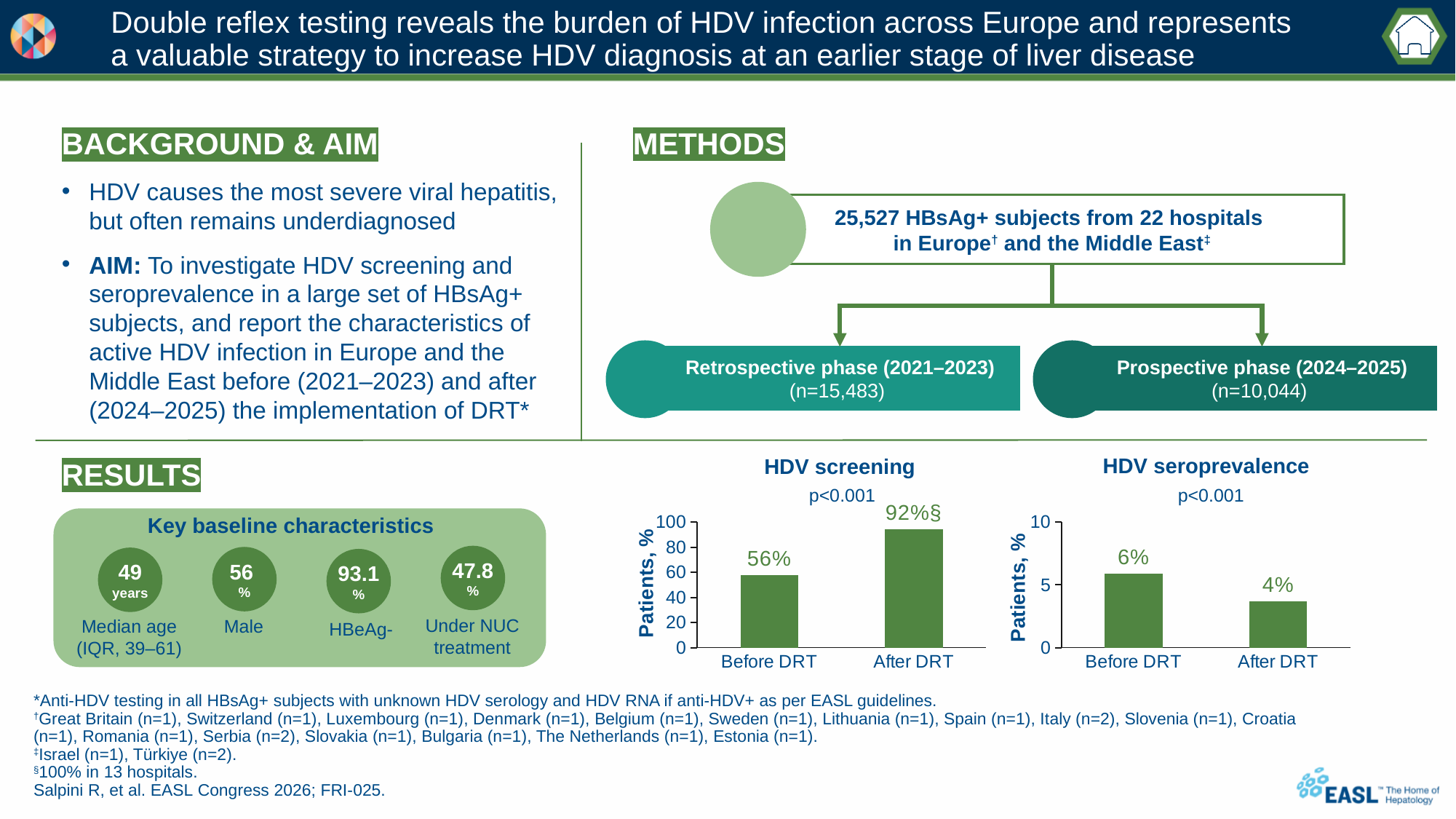
In the HDV seroprevalence chart, what is the difference between the Before DRT and After DRT values? 2% How many categories are shown in the HDV screening chart? 2 In the HDV seroprevalence chart, what is the value for Before DRT? 6% In the HDV screening chart, what is the difference between the After DRT and Before DRT values? 36% In the HDV screening chart, what is the value for Before DRT? 56% In the HDV screening chart, which category has the highest value? After DRT In the HDV seroprevalence chart, which category has the lowest value? After DRT In the HDV seroprevalence chart, what is the value for After DRT? 4% In the HDV screening chart, what is the value for After DRT? 92% What kind of chart is the HDV seroprevalence chart? Bar chart What is the y-axis label of the HDV screening chart? Patients, % In the HDV seroprevalence chart, is the value for Before DRT greater or less than 5? greater